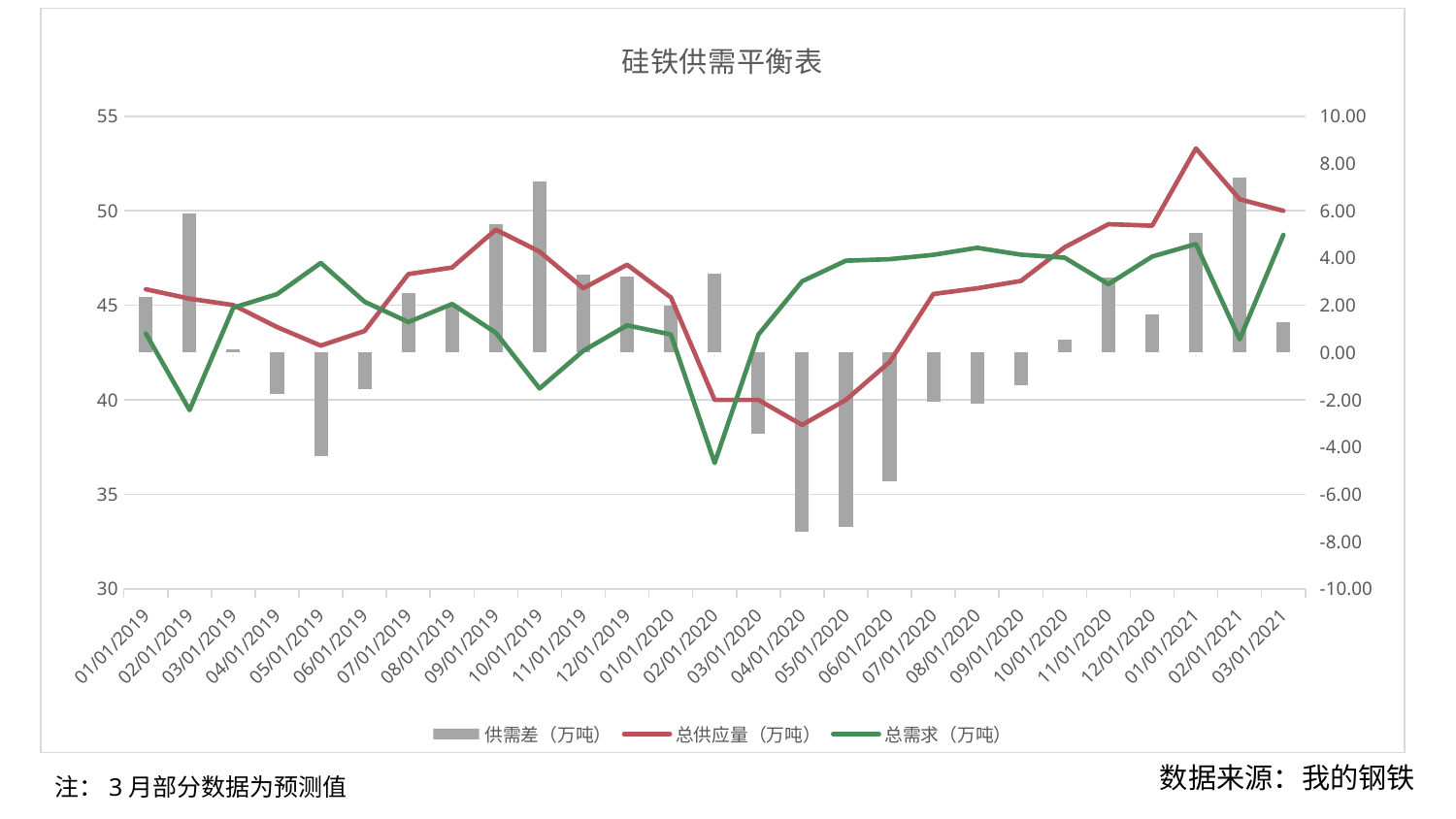
Is the value of 总供应量（万吨） at 01/01/2021 greater or less than 50? greater At which date does the 总供应量（万吨） line reach its lowest value? 04/01/2020 What kind of chart is this? Combination bar and line chart At 05/01/2019, which is larger: 总供应量（万吨） or 总需求（万吨）? 总需求（万吨） At which date does the 总供应量（万吨） line reach its highest value? 01/01/2021 Is the value of 总需求（万吨） at 02/01/2020 greater or less than 40? less How many series does the legend list? 3 How many dates are shown on the x axis? 27 Is the 供需差（万吨） bar at 06/01/2020 greater or less than -4.00? less At which date does the 总需求（万吨） line reach its lowest value? 02/01/2020 Which series is drawn as grey bars? 供需差（万吨） What is the title of the chart? 硅铁供需平衡表